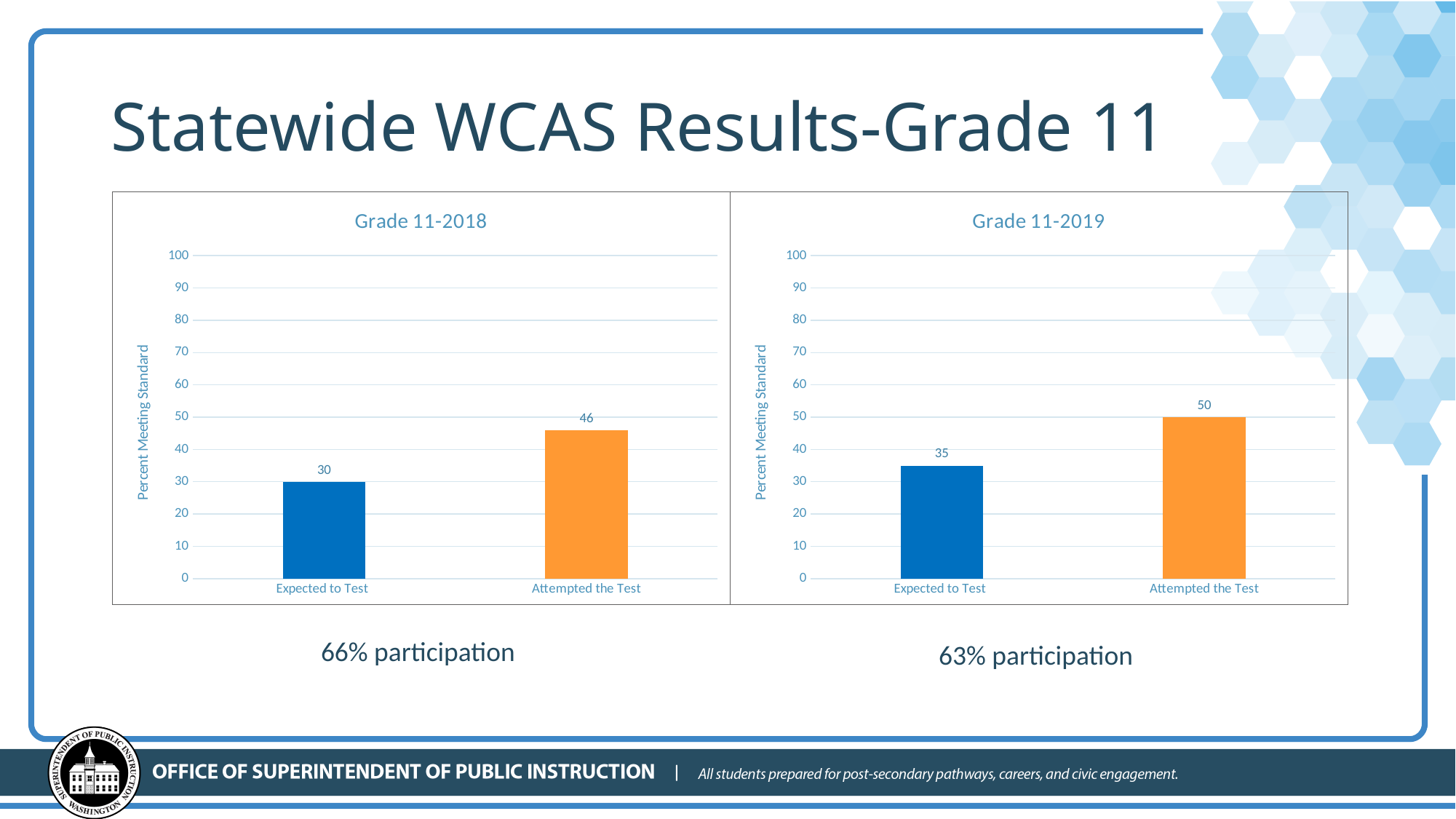
What is the y-axis label of the Grade 11-2019 chart? Percent Meeting Standard In the Grade 11-2018 chart, what is the value for Expected to Test? 30 In the Grade 11-2018 chart, what is the difference between Attempted the Test and Expected to Test? 16 Which is larger: Expected to Test in the Grade 11-2018 chart or Expected to Test in the Grade 11-2019 chart? Grade 11-2019 How many categories are shown in the Grade 11-2019 chart? 2 In the Grade 11-2018 chart, what is the value for Attempted the Test? 46 In the Grade 11-2018 chart, which category has the highest value? Attempted the Test What kind of chart is the Grade 11-2018 chart? Bar chart In the Grade 11-2019 chart, what is the difference between Attempted the Test and Expected to Test? 15 In the Grade 11-2019 chart, what is the value for Attempted the Test? 50 In the Grade 11-2019 chart, which category has the lowest value? Expected to Test In the Grade 11-2019 chart, what is the value for Expected to Test? 35